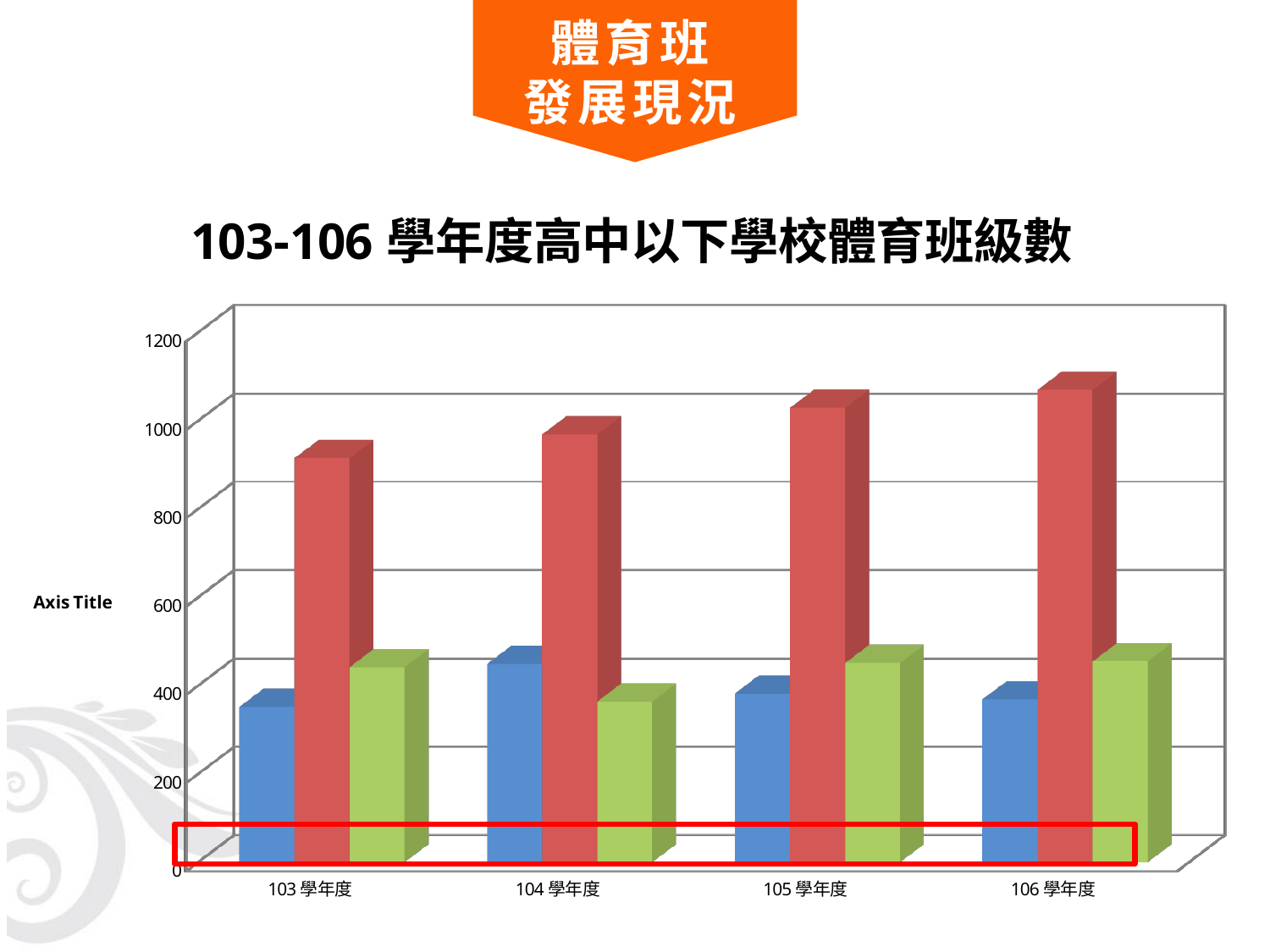
Is the red bar for 103 學年度 greater or less than 800? greater Is the blue bar for 103 學年度 greater or less than 400? less What is the title of the chart? 103-106 學年度高中以下學校體育班級數 For 104 學年度, which is larger, the blue bar or the green bar? the blue bar For 103 學年度, which is larger, the red bar or the green bar? the red bar What kind of chart is shown on the slide? bar chart Do the red bars rise or fall from 103 學年度 to 106 學年度? rise Is the green bar for 104 學年度 greater or less than 400? less In which school year is the red bar the lowest? 103 學年度 What text is shown as the vertical axis title? Axis Title In which school year is the red bar the highest? 106 學年度 How many school-year categories are shown on the x axis? 4